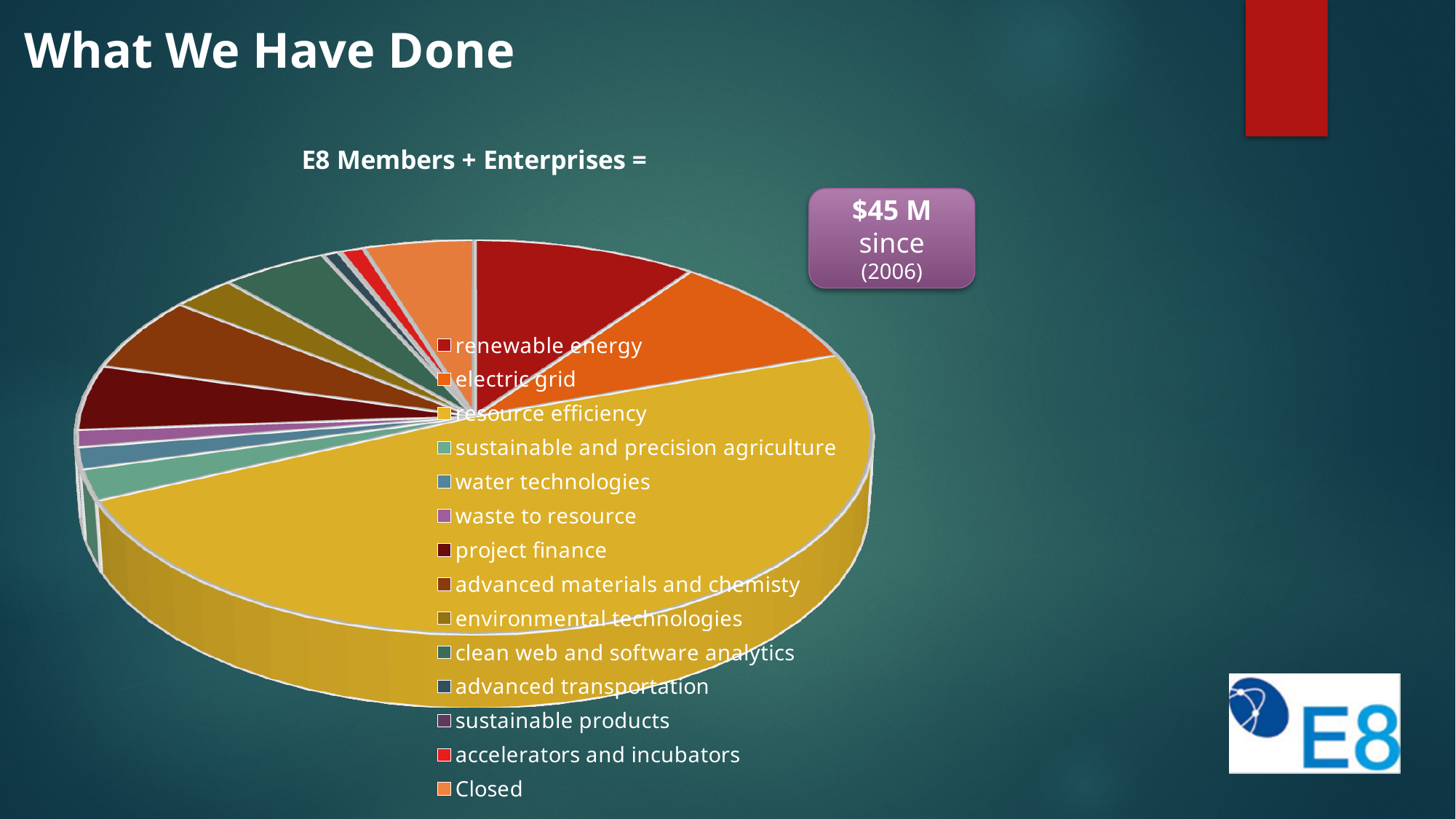
What is the title of the chart? E8 Members + Enterprises = Which slice is larger, renewable energy or waste to resource? renewable energy How many categories does the pie chart's legend list? 14 Which category has the largest slice of the pie? resource efficiency Which slice is larger, project finance or sustainable products? project finance What colour is the resource efficiency slice? yellow What kind of chart is shown on the slide? pie chart Which category is listed last in the legend? Closed Which slice is larger, electric grid or water technologies? electric grid